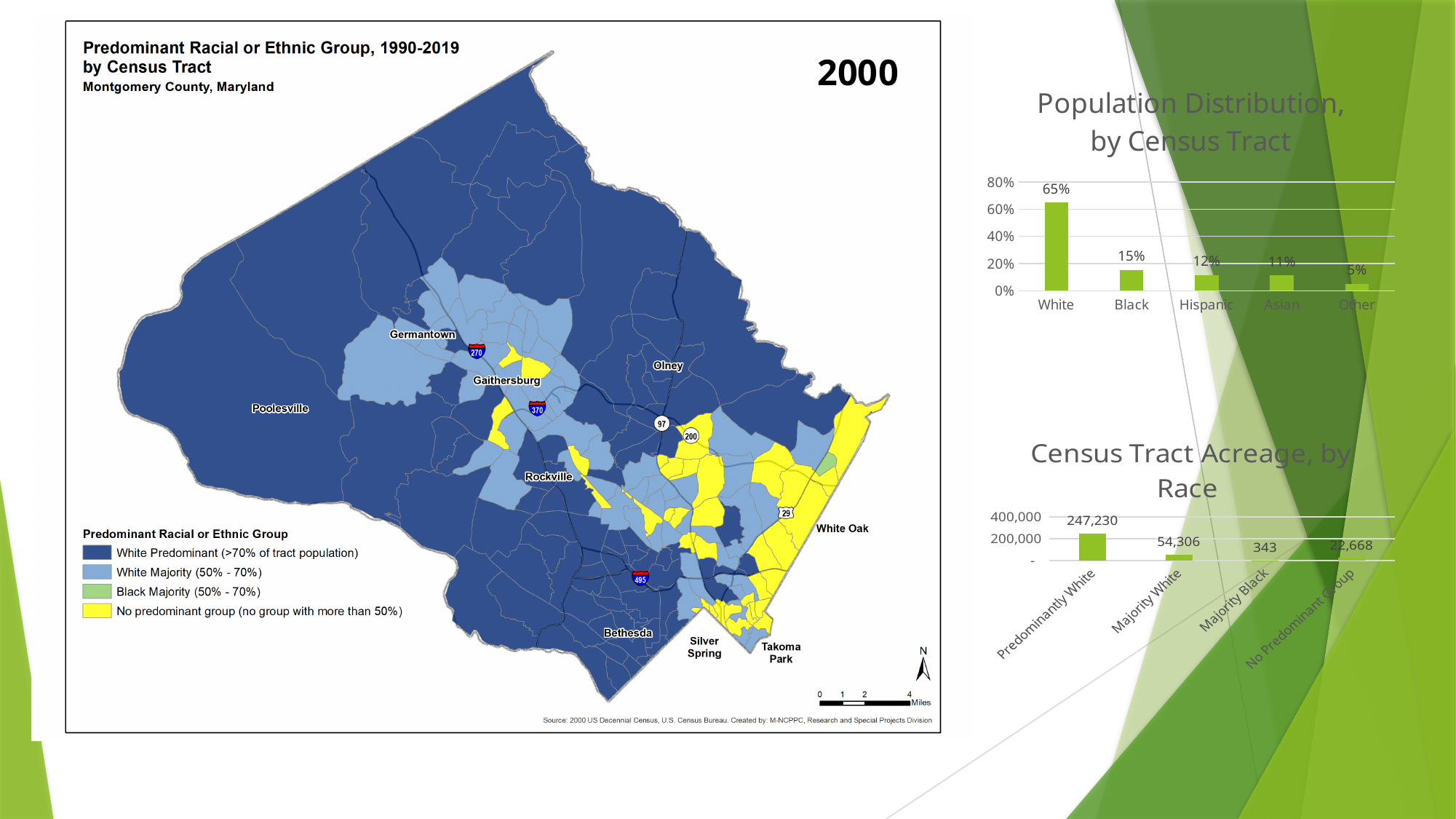
In the 'Population Distribution, by Census Tract' chart, what is the value for White? 65% In the 'Census Tract Acreage, by Race' chart, what is the value for Majority White? 54,306 In the 'Census Tract Acreage, by Race' chart, what is the difference between Predominantly White and Majority White? 192,924 In the 'Census Tract Acreage, by Race' chart, which category has the highest value? Predominantly White What kind of chart is 'Census Tract Acreage, by Race'? bar chart In the 'Population Distribution, by Census Tract' chart, what is the difference between the values for White and Black? 50% In the 'Population Distribution, by Census Tract' chart, which category has the lowest value? Other In the 'Population Distribution, by Census Tract' chart, how many categories are shown on the x axis? 5 In the 'Census Tract Acreage, by Race' chart, what is the value for Majority Black? 343 In the 'Population Distribution, by Census Tract' chart, what is the value for Hispanic? 12% In the 'Census Tract Acreage, by Race' chart, which is larger: Majority White or No Predominant Group? Majority White In the 'Population Distribution, by Census Tract' chart, is the value for Black greater or less than 20%? less